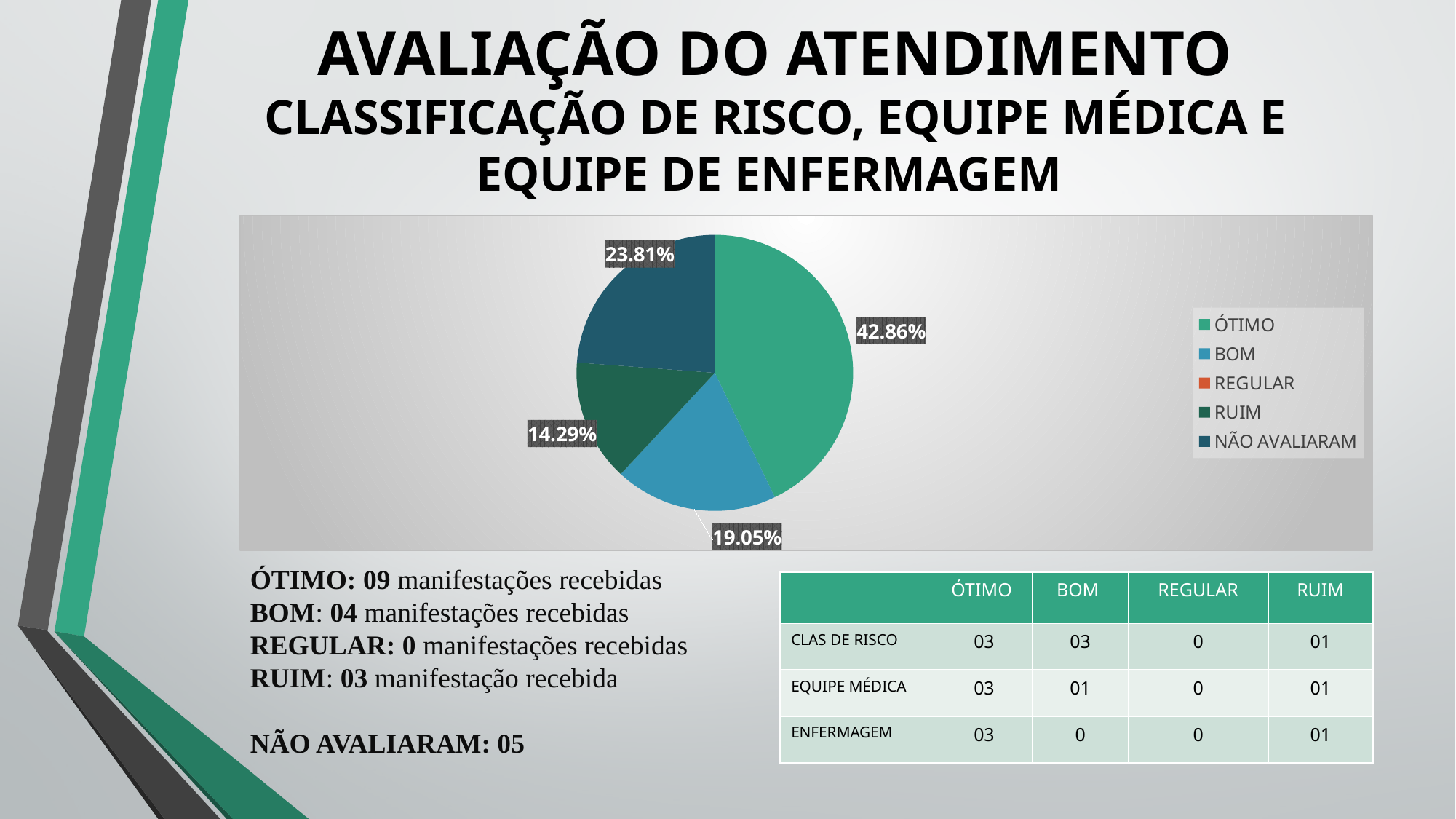
Which legend entry is shown in orange? REGULAR What type of chart is shown on the slide? Pie chart Which slice is larger, BOM or NÃO AVALIARAM? NÃO AVALIARAM What percentage is shown for the RUIM slice? 14.29% What share of the pie chart does ÓTIMO represent? 42.86% What is the difference in percentage points between the NÃO AVALIARAM and RUIM slices? 9.52 Among the slices with printed percentages, which category has the smallest share? RUIM What percentage is shown for the BOM slice of the pie chart? 19.05% What is the difference in percentage points between the ÓTIMO and BOM slices? 23.81 How many categories does the legend of the pie chart list? 5 What percentage is shown for the NÃO AVALIARAM slice? 23.81% Which category has the largest slice of the pie chart? ÓTIMO